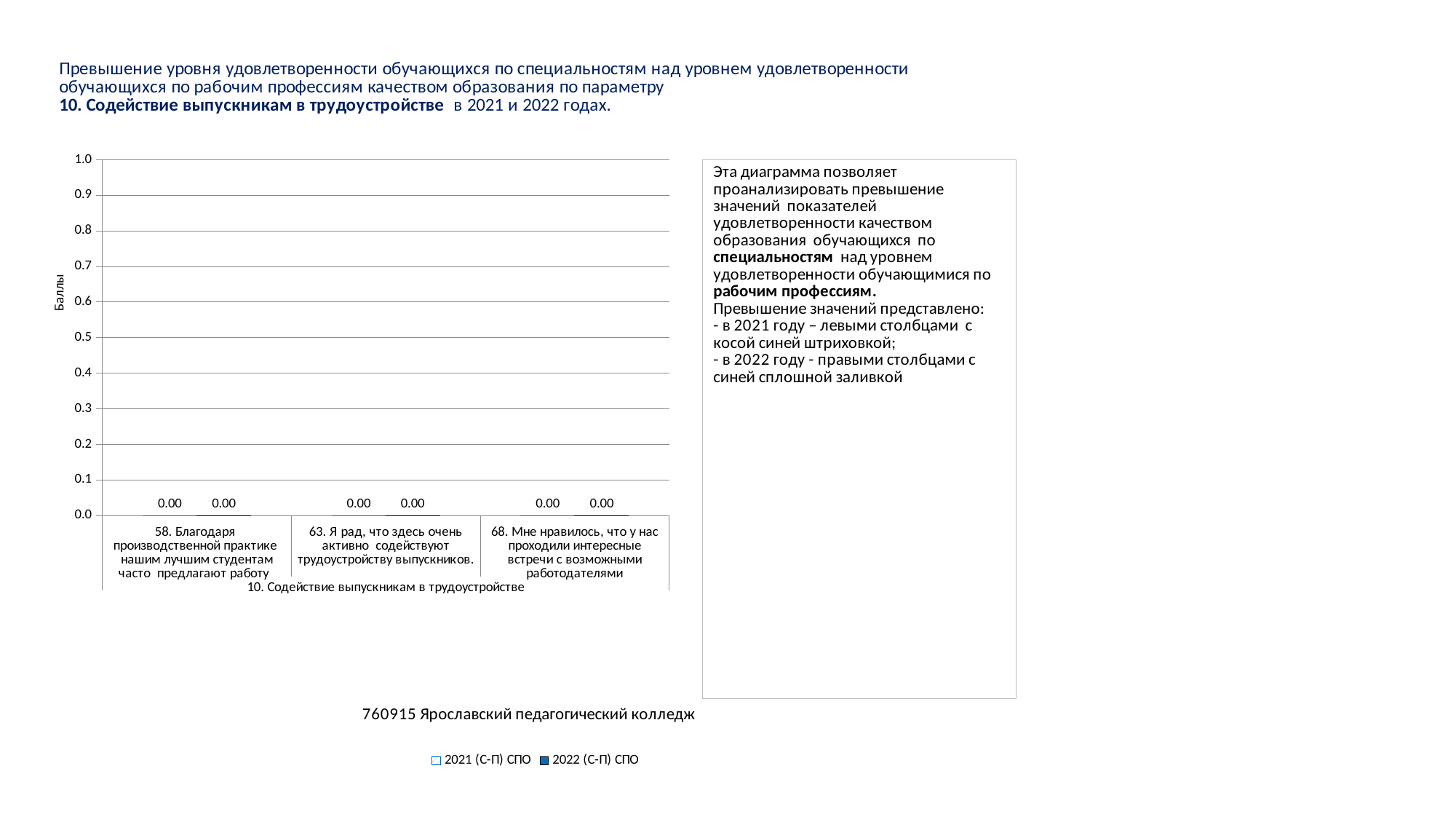
What is the label of the vertical axis? Баллы What is the value for 2021 (С-П) СПО for category 58 (Благодаря производственной практике нашим лучшим студентам часто предлагают работу)? 0.00 What is the difference between the 2021 (С-П) СПО and 2022 (С-П) СПО values for category 63? 0.00 How many categories are shown on the x axis of the chart? 3 What is the title shown below the chart? 760915 Ярославский педагогический колледж How many series does the legend list? 2 What is the value for 2022 (С-П) СПО for category 58? 0.00 What is the highest tick value shown on the vertical axis? 1.0 What is the value for 2022 (С-П) СПО for category 63 (Я рад, что здесь очень активно содействуют трудоустройству выпускников)? 0.00 What kind of chart is shown on the slide? bar chart What is the value for 2021 (С-П) СПО for category 68 (Мне нравилось, что у нас проходили интересные встречи с возможными работодателями)? 0.00 Is the value for 2022 (С-П) СПО for category 68 greater or less than 0.5? less